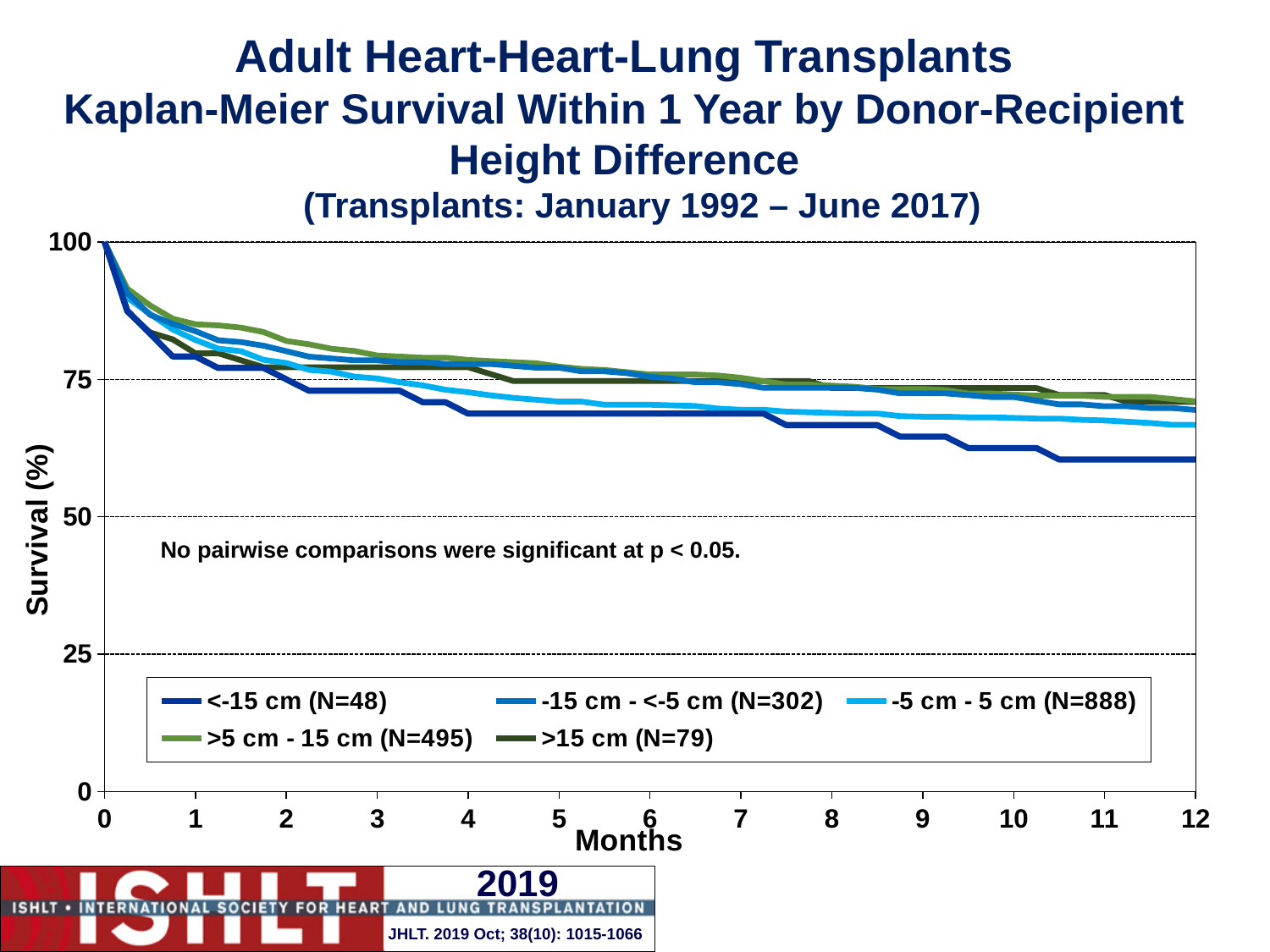
Is the survival value for the -5 cm - 5 cm group at 12 months greater or less than 75? less At 12 months, which has higher survival: the <-15 cm group or the -5 cm - 5 cm group? -5 cm - 5 cm Is the survival value for the <-15 cm group at 12 months greater or less than 50? greater What is the survival value for all groups at month 0? 100 How many series does the legend list? 5 According to the legend, how many patients (N) are in the -5 cm - 5 cm group? 888 Is the survival value for the <-15 cm group at 12 months greater or less than 75? less Do the survival curves rise or fall as months increase? fall Which height-difference group has the lowest survival at 12 months? <-15 cm (N=48) What does the annotation on the chart say about pairwise comparisons? No pairwise comparisons were significant at p < 0.05. What kind of chart is shown on the slide? line chart At 2 months, which has higher survival: the <-15 cm group or the >5 cm - 15 cm group? >5 cm - 15 cm